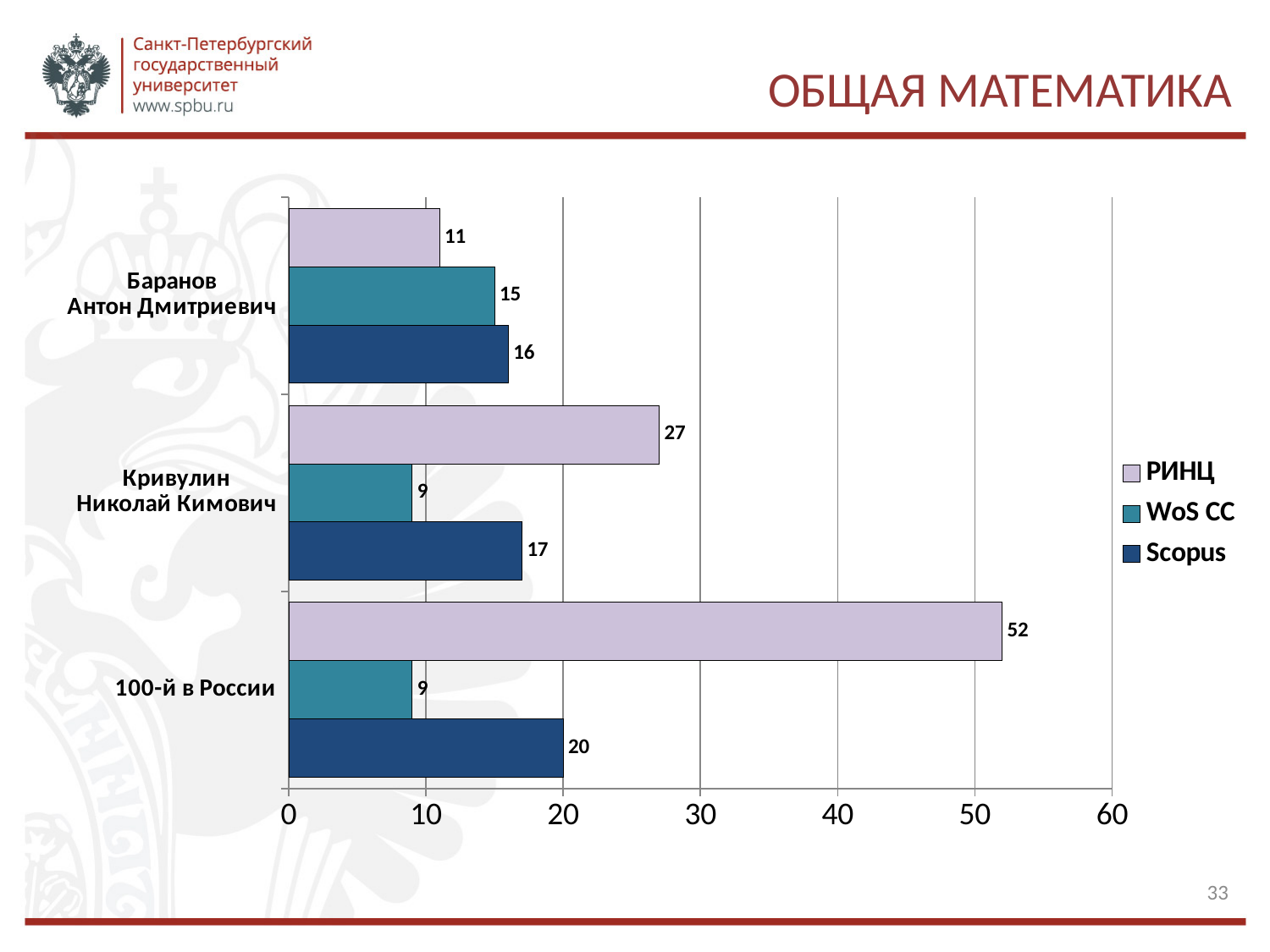
What is the РИНЦ value for Баранов Антон Дмитриевич? 11 What is the difference between the РИНЦ value for 100-й в России and the РИНЦ value for Кривулин Николай Кимович? 25 What is the WoS CC value for 100-й в России? 9 What is the Scopus value for Кривулин Николай Кимович? 17 Which is larger: the WoS CC value for Баранов Антон Дмитриевич or the WoS CC value for Кривулин Николай Кимович? Баранов Антон Дмитриевич How many series does the legend list? 3 What kind of chart is shown on the slide? bar chart Is the Scopus value for 100-й в России greater or less than 10? greater How many categories are shown on the chart? 3 What is the title of the slide? ОБЩАЯ МАТЕМАТИКА Which category has the lowest РИНЦ value? Баранов Антон Дмитриевич Which category has the highest РИНЦ value? 100-й в России